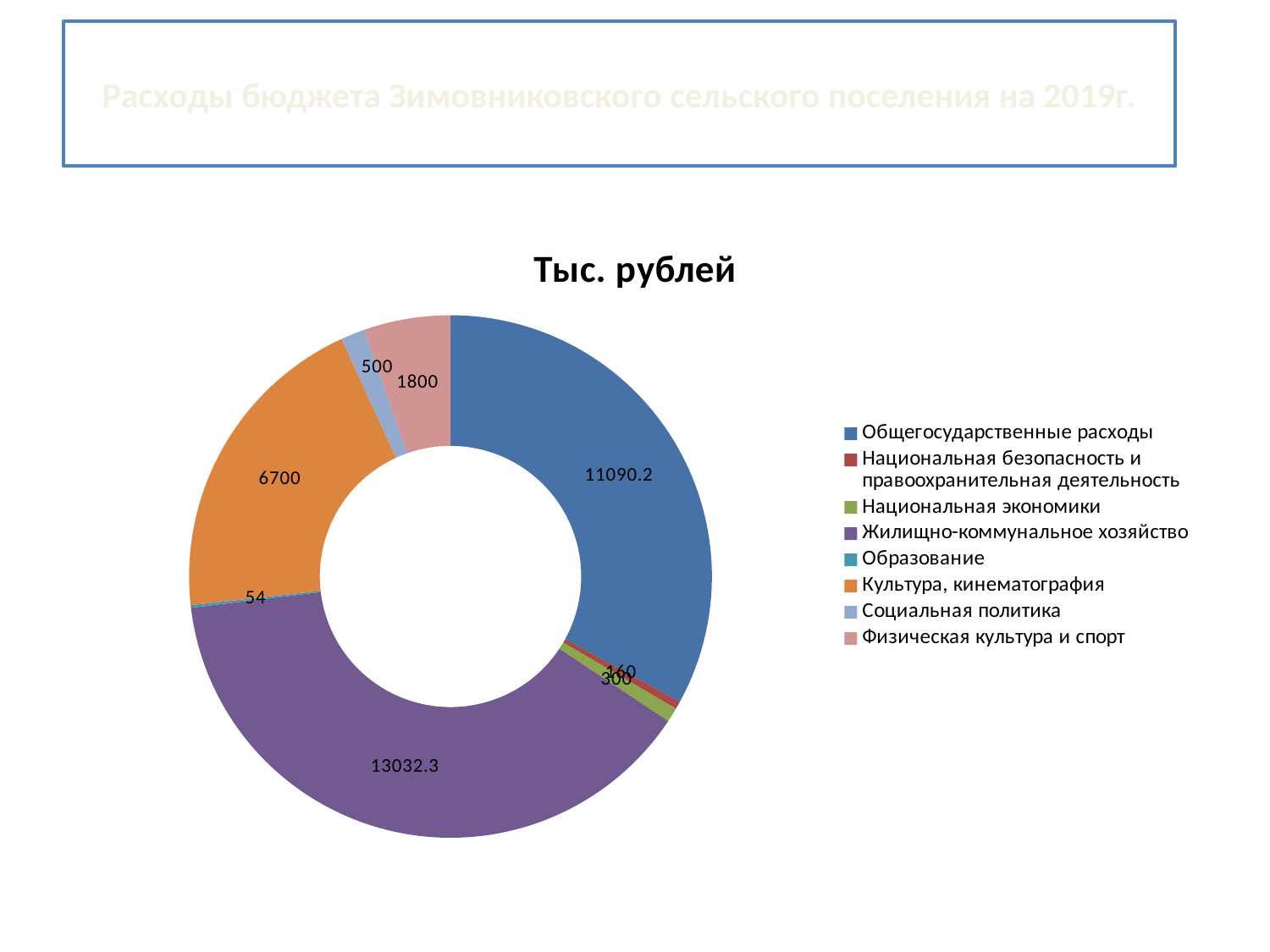
Which category has the smallest value? Образование What is the title of the chart? Тыс. рублей What is the difference between the values for Жилищно-коммунальное хозяйство and Общегосударственные расходы? 1942.1 How many categories does the legend list? 8 What is the value for Образование? 54 What is the value for Общегосударственные расходы? 11090.2 What is the value for Жилищно-коммунальное хозяйство? 13032.3 What is the value for Культура, кинематография? 6700 Which is larger: Культура, кинематография or Физическая культура и спорт? Культура, кинематография What is the value for Физическая культура и спорт? 1800 Which category has the largest value? Жилищно-коммунальное хозяйство What is the value for Социальная политика? 500